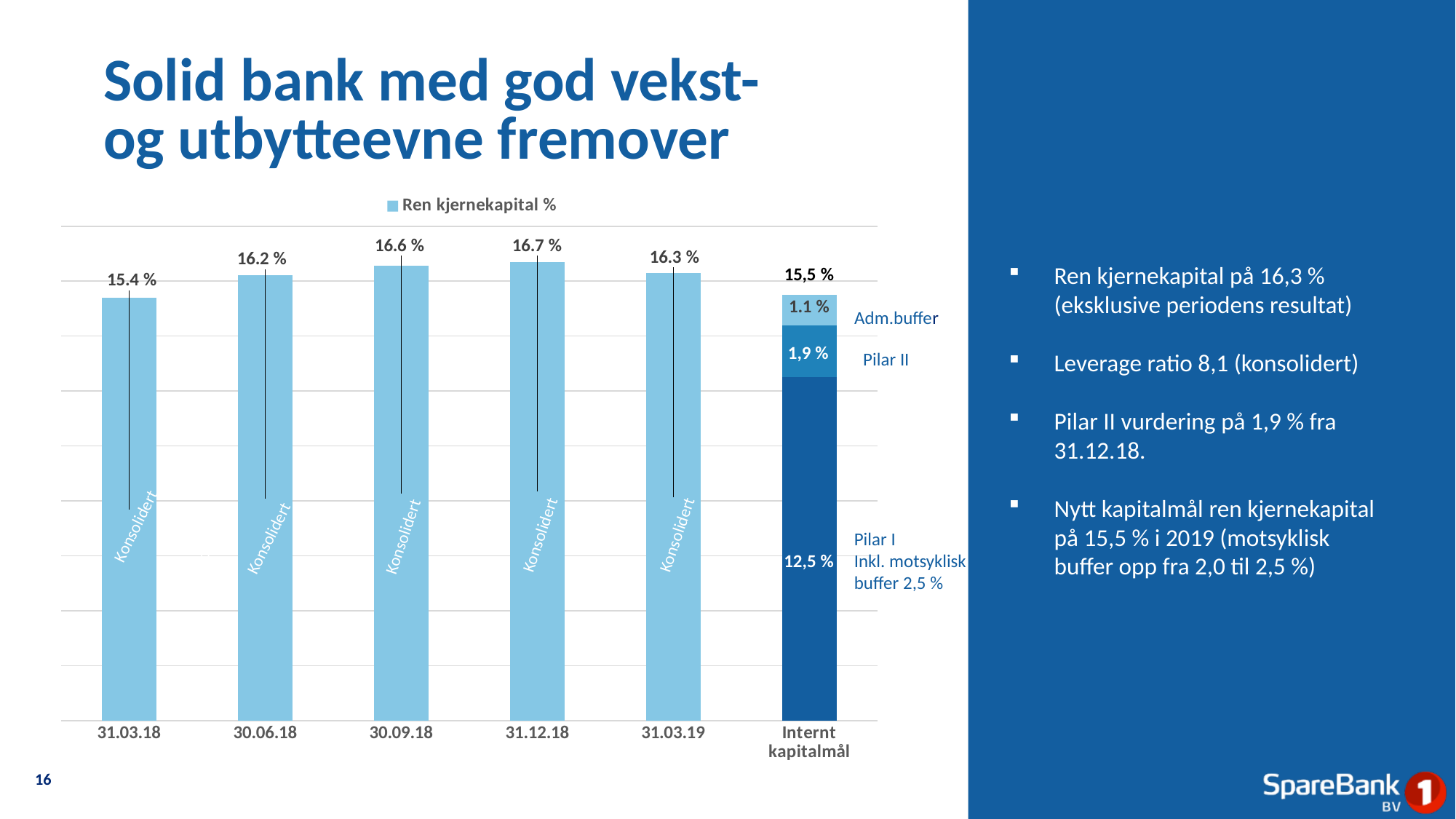
Does the Ren kjernekapital % rise or fall from 31.03.18 to 31.12.18? Rise What is the Ren kjernekapital % value for 31.03.18? 15.4 % What is the Ren kjernekapital % value for 31.03.19? 16.3 % What kind of chart is shown on the slide? Bar chart What is the total of the stacked Internt kapitalmål bar? 15,5 % Which date has the lowest Ren kjernekapital %? 31.03.18 Which is larger, the Ren kjernekapital % for 30.06.18 or for 30.09.18? 30.09.18 What is the Pilar I value in the Internt kapitalmål bar? 12,5 % What is the difference between the Ren kjernekapital % for 31.12.18 and 31.03.18? 1.3 % What is the Ren kjernekapital % value for 30.09.18? 16.6 % Which date has the highest Ren kjernekapital %? 31.12.18 How many bars are shown along the x axis of the chart? 6